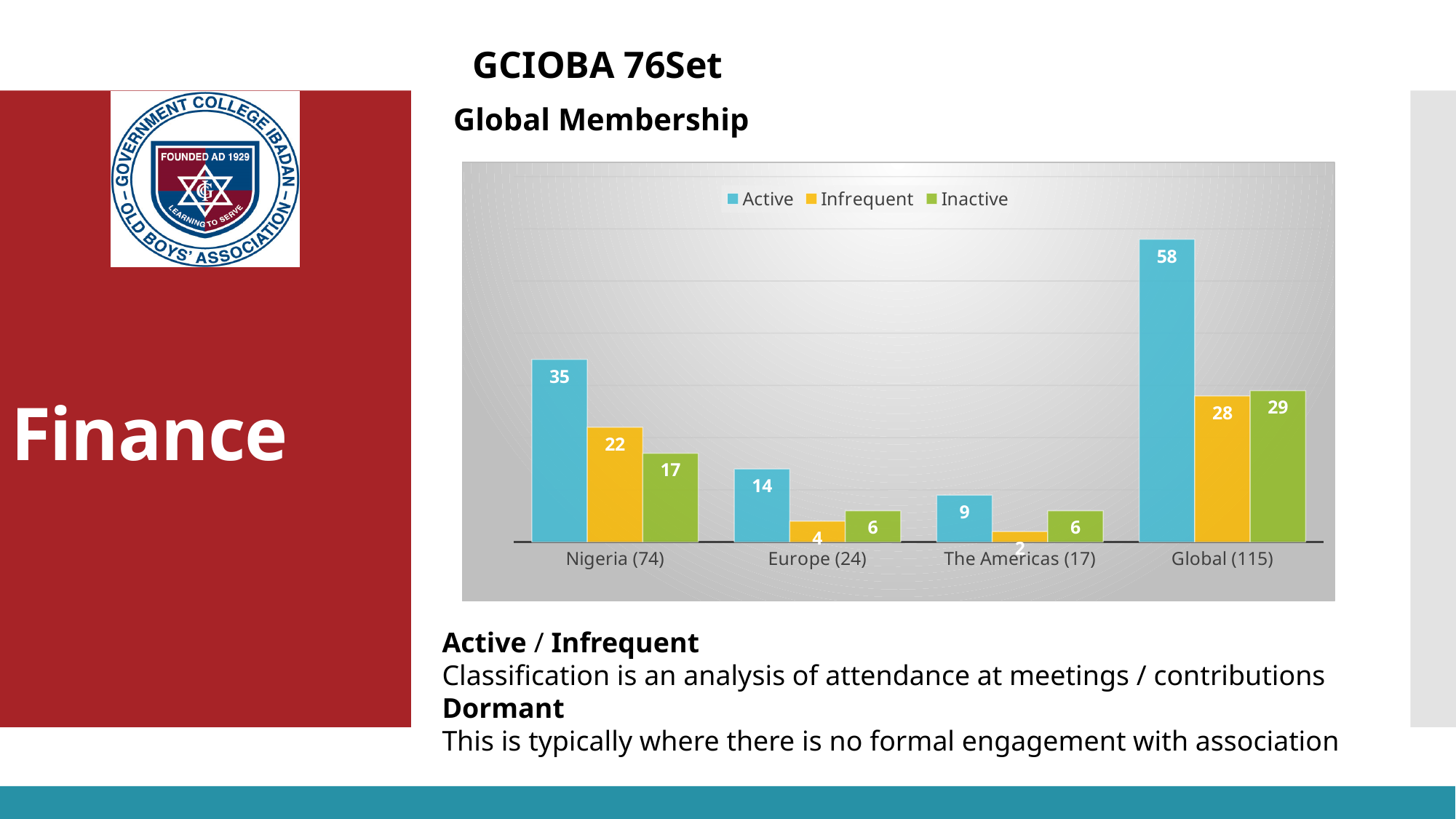
Which category has the lowest Infrequent value? The Americas (17) What is the Active value for Nigeria (74)? 35 Which is larger for Global (115): the Infrequent value or the Inactive value? Inactive What is the Infrequent value for Global (115)? 28 Which category has the highest Active value? Global (115) Which series is shown in green in the legend? Inactive What is the difference between the Active and Inactive values for Nigeria (74)? 18 What kind of chart is shown? Bar chart What is the Infrequent value for The Americas (17)? 2 How many series does the legend list? 3 What is the Inactive value for Europe (24)? 6 How many categories are shown on the x axis? 4